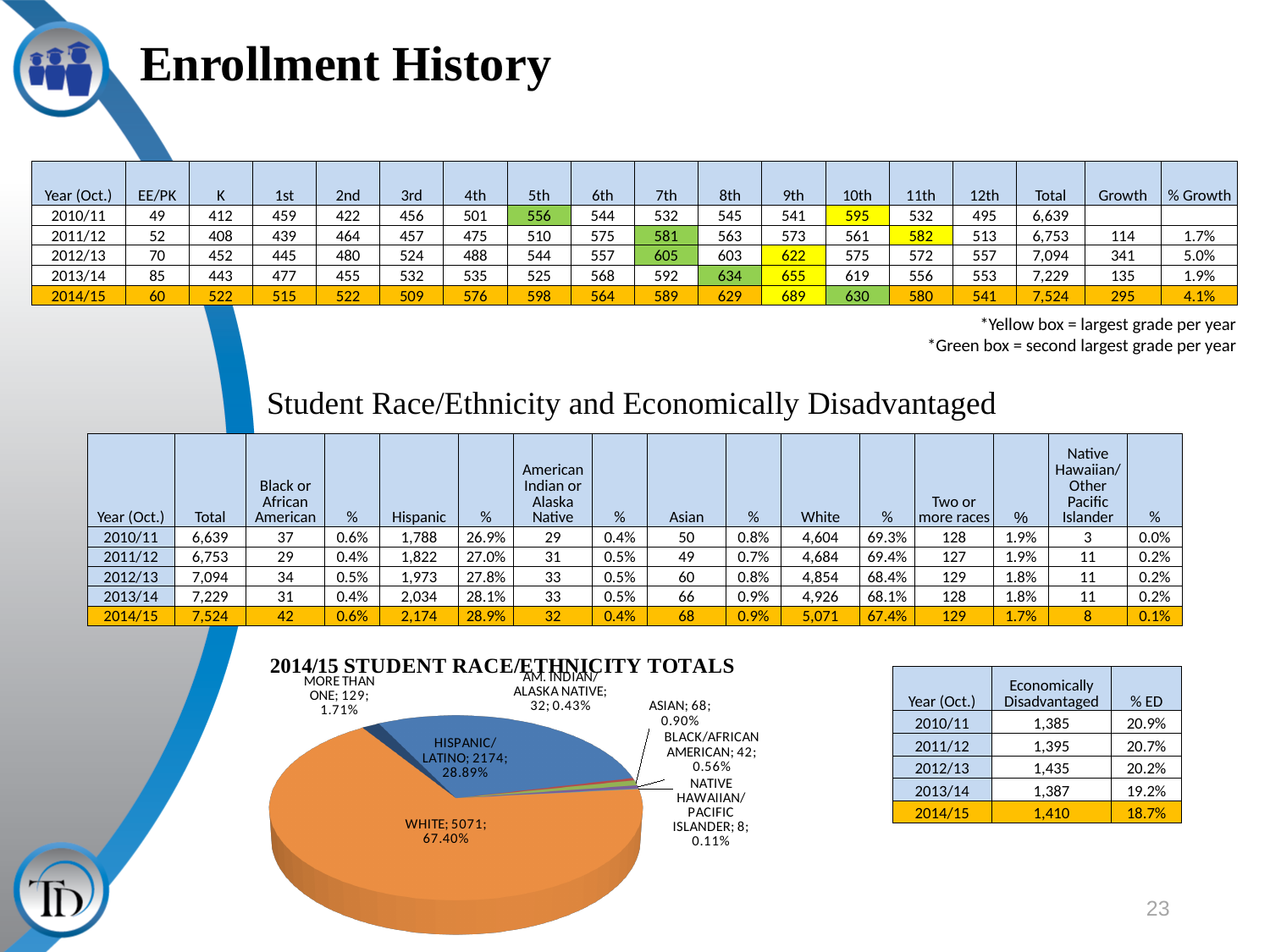
How many slices does the pie chart have? 7 Which category has the smallest slice in the pie chart? NATIVE HAWAIIAN/PACIFIC ISLANDER What percentage share does the HISPANIC/LATINO slice have in the pie chart? 28.89% What is the value shown for the ASIAN slice in the pie chart? 68 In the pie chart, which is larger: the MORE THAN ONE slice or the ASIAN slice? MORE THAN ONE What is the title of the pie chart? 2014/15 STUDENT RACE/ETHNICITY TOTALS What is the value shown for the AM. INDIAN/ALASKA NATIVE slice in the pie chart? 32 Which category has the largest slice in the pie chart? WHITE What percentage share does the BLACK/AFRICAN AMERICAN slice have in the pie chart? 0.56% What is the difference between the WHITE and HISPANIC/LATINO values in the pie chart? 2897 What kind of chart is shown on the slide? Pie chart What is the value shown for the WHITE slice in the pie chart? 5071